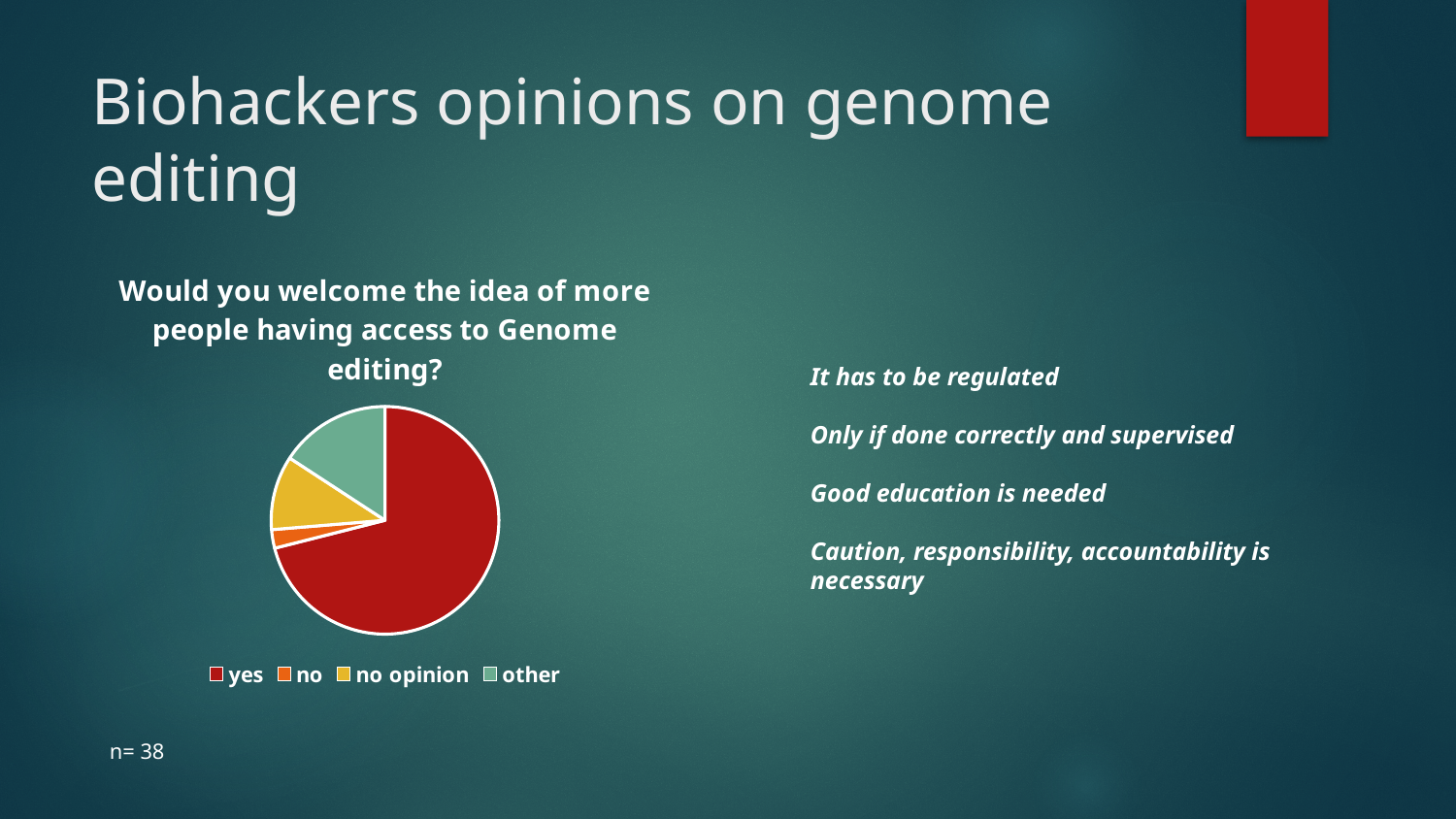
Which slice is larger in the pie chart, 'other' or 'no'? other Which slice is larger in the pie chart, 'no opinion' or 'no'? no opinion Which category has the smallest slice of the pie chart? no What are the legend entries of the pie chart, in order? yes, no, no opinion, other What colour is the 'yes' slice in the pie chart? red Does the 'yes' slice take up more or less than half of the pie chart? more What kind of chart is shown on the slide? pie chart What is the title of the pie chart? Would you welcome the idea of more people having access to Genome editing? Which category has the largest slice of the pie chart? yes How many categories does the pie chart have? 4